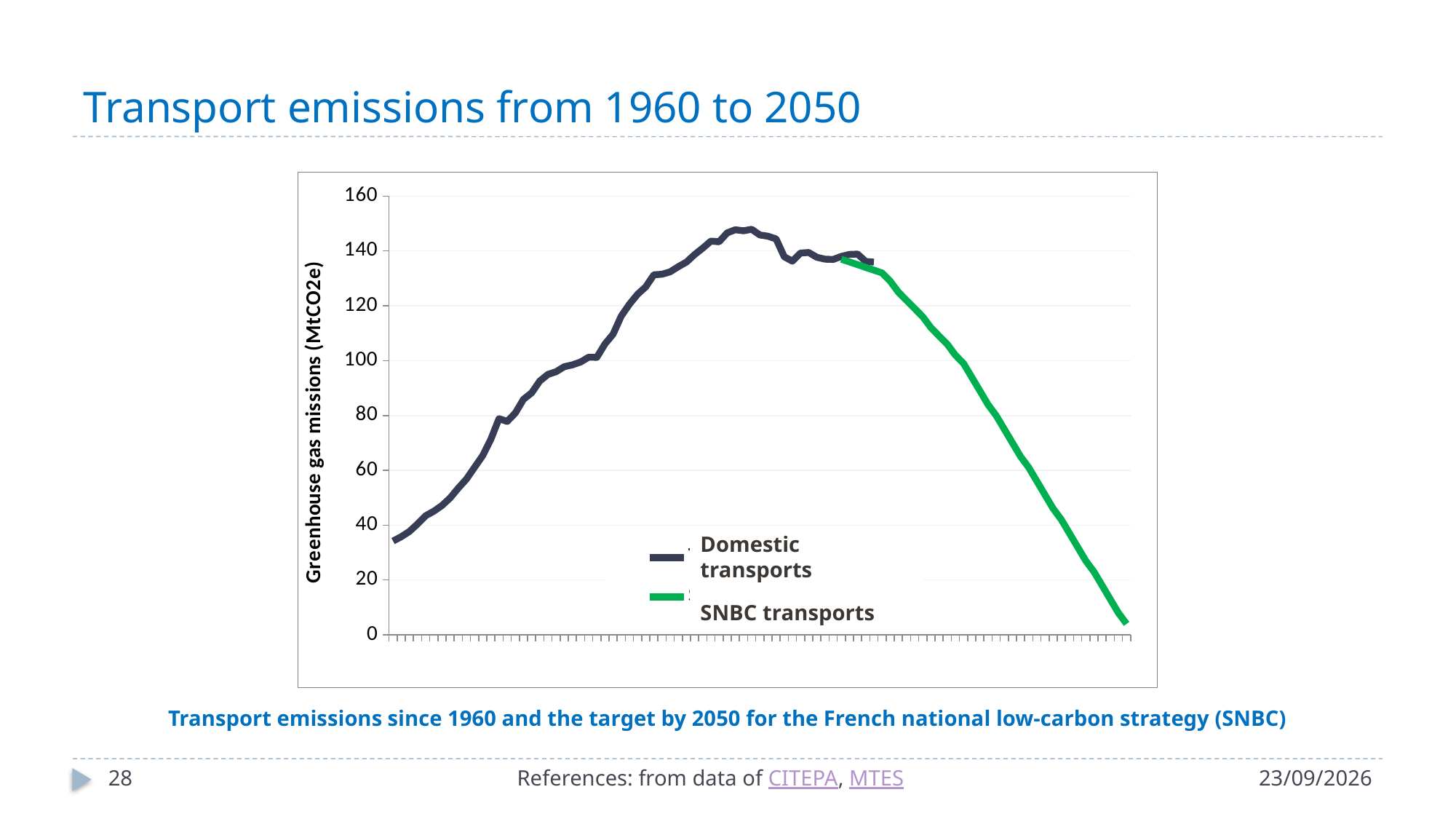
How many series does the chart legend list? 2 Does the Domestic transports line rise or fall overall from its start to its peak? rise Is the final value of the SNBC transports line greater or less than 20? less What is the highest value shown on the vertical axis? 160 Is the peak value of the Domestic transports line greater or less than 140? greater Is the starting value of the Domestic transports line greater or less than 40? less Which series is drawn in green? SNBC transports What kind of chart is shown on the slide? line chart Does the SNBC transports line rise or fall along the x axis? fall Which series reaches the higher maximum value, Domestic transports or SNBC transports? Domestic transports What is the label of the vertical axis? Greenhouse gas missions (MtCO2e)